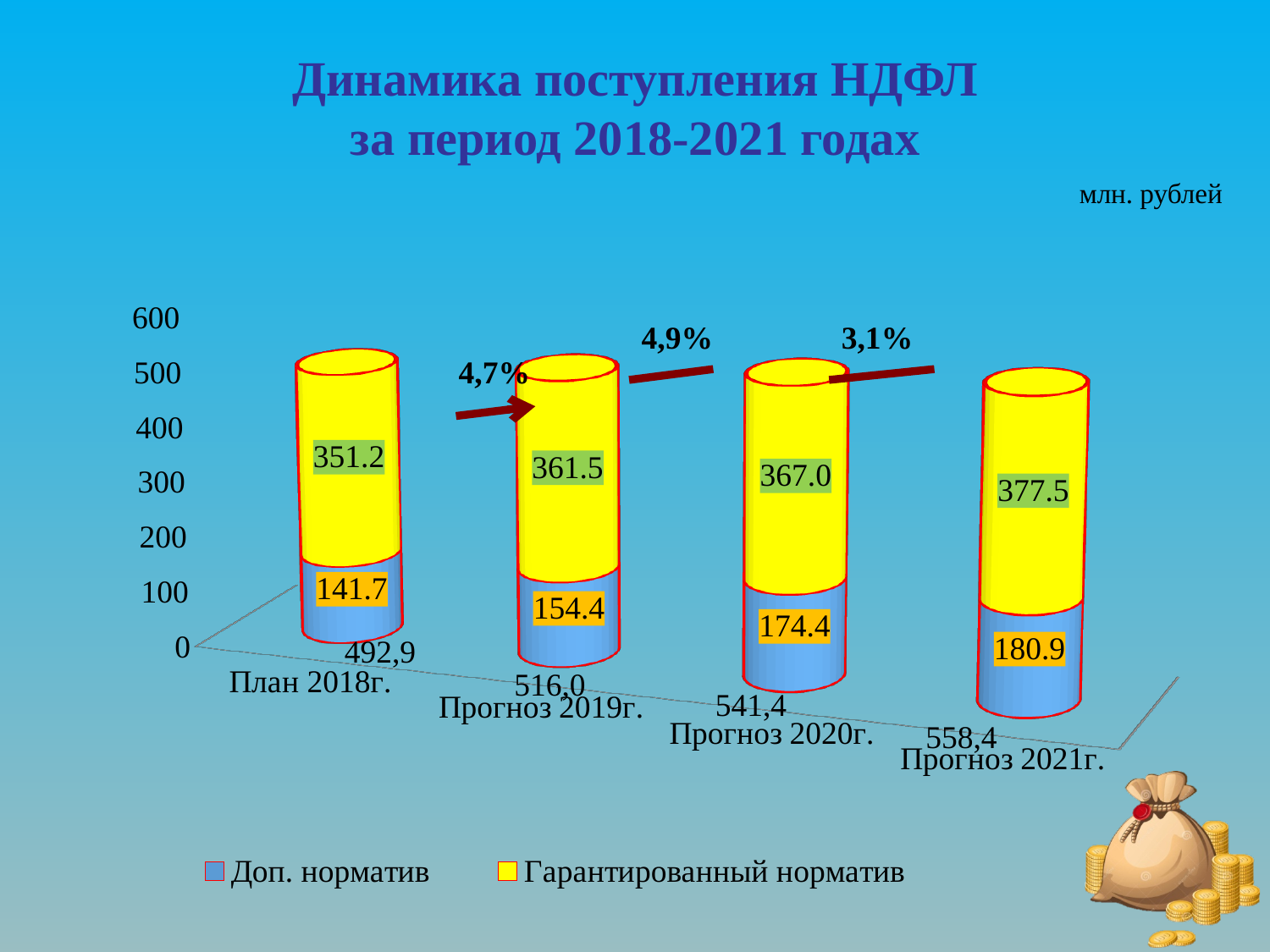
Which category has the highest value for Гарантированный норматив? Прогноз 2021г. What is the value of Гарантированный норматив for План 2018г.? 351.2 What is the difference between the Гарантированный норматив values for Прогноз 2021г. and План 2018г.? 26.3 What is the value of Доп. норматив for Прогноз 2021г.? 180.9 Which category has the lowest value for Доп. норматив? План 2018г. What is the total of the stacked bar for Прогноз 2019г.? 516,0 Which is larger: Доп. норматив for Прогноз 2019г. or Доп. норматив for Прогноз 2020г.? Прогноз 2020г. How many categories are shown on the x axis? 4 How many series does the legend list? 2 Do the Гарантированный норматив values rise or fall from План 2018г. to Прогноз 2021г.? Rise What kind of chart is shown on the slide? Stacked bar chart What is the value of Доп. норматив for Прогноз 2020г.? 174.4